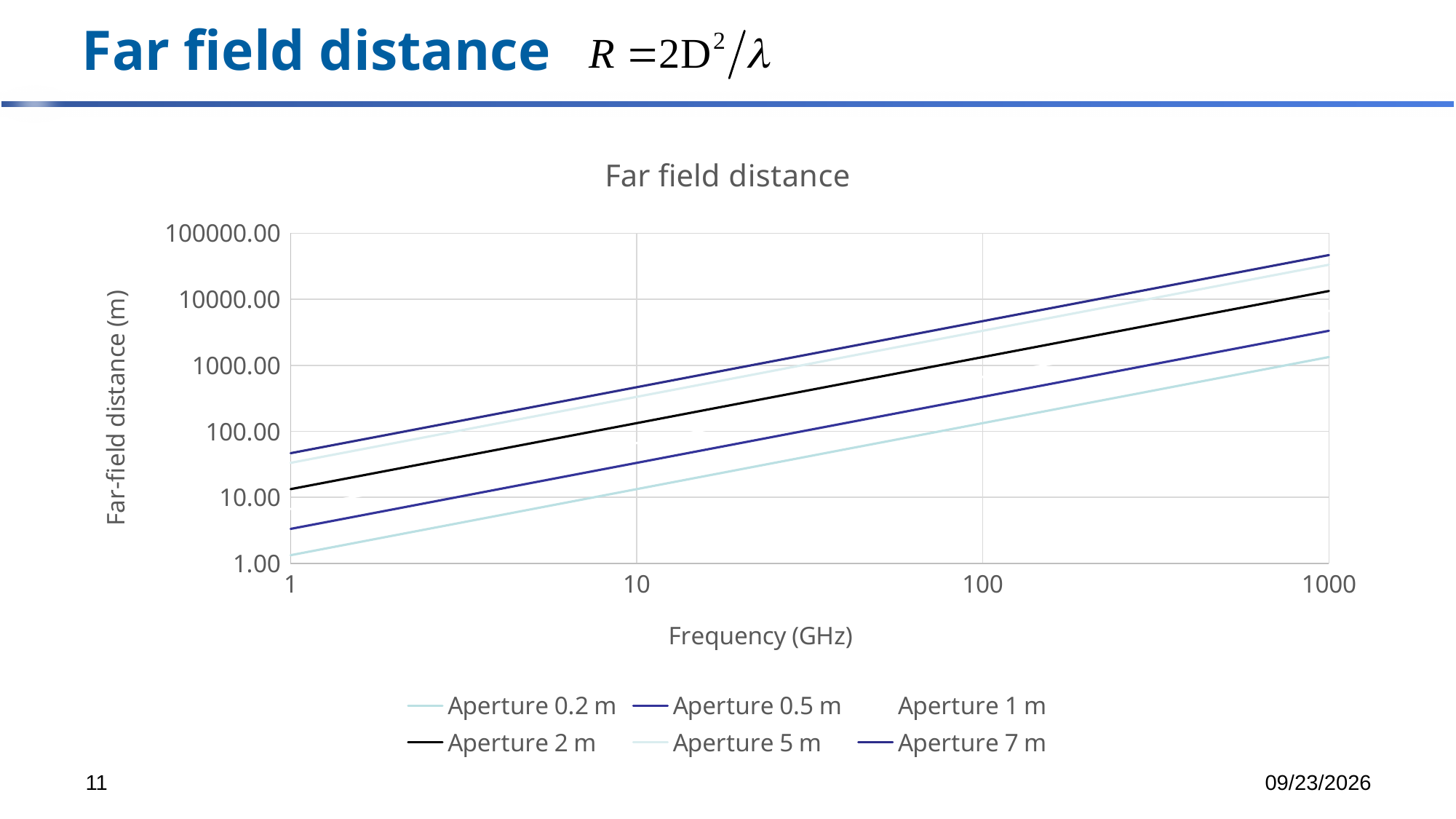
What is the title of the chart? Far field distance Which aperture series has the lowest far-field distance across the frequency range? Aperture 0.2 m Is the far-field distance for Aperture 2 m at 1 GHz greater or less than 10.00? greater Which aperture series has the highest far-field distance across the frequency range? Aperture 7 m How many series does the legend list? 6 Is the far-field distance for Aperture 0.5 m at 1 GHz greater or less than 10.00? less Do the far-field distance values rise or fall as frequency increases along the x axis? rise What is the label of the x axis? Frequency (GHz) At 1000 GHz, which has the larger far-field distance: Aperture 7 m or Aperture 2 m? Aperture 7 m Is the far-field distance for Aperture 0.2 m at 1000 GHz greater or less than 1000.00? greater What kind of chart is shown on the slide? line chart